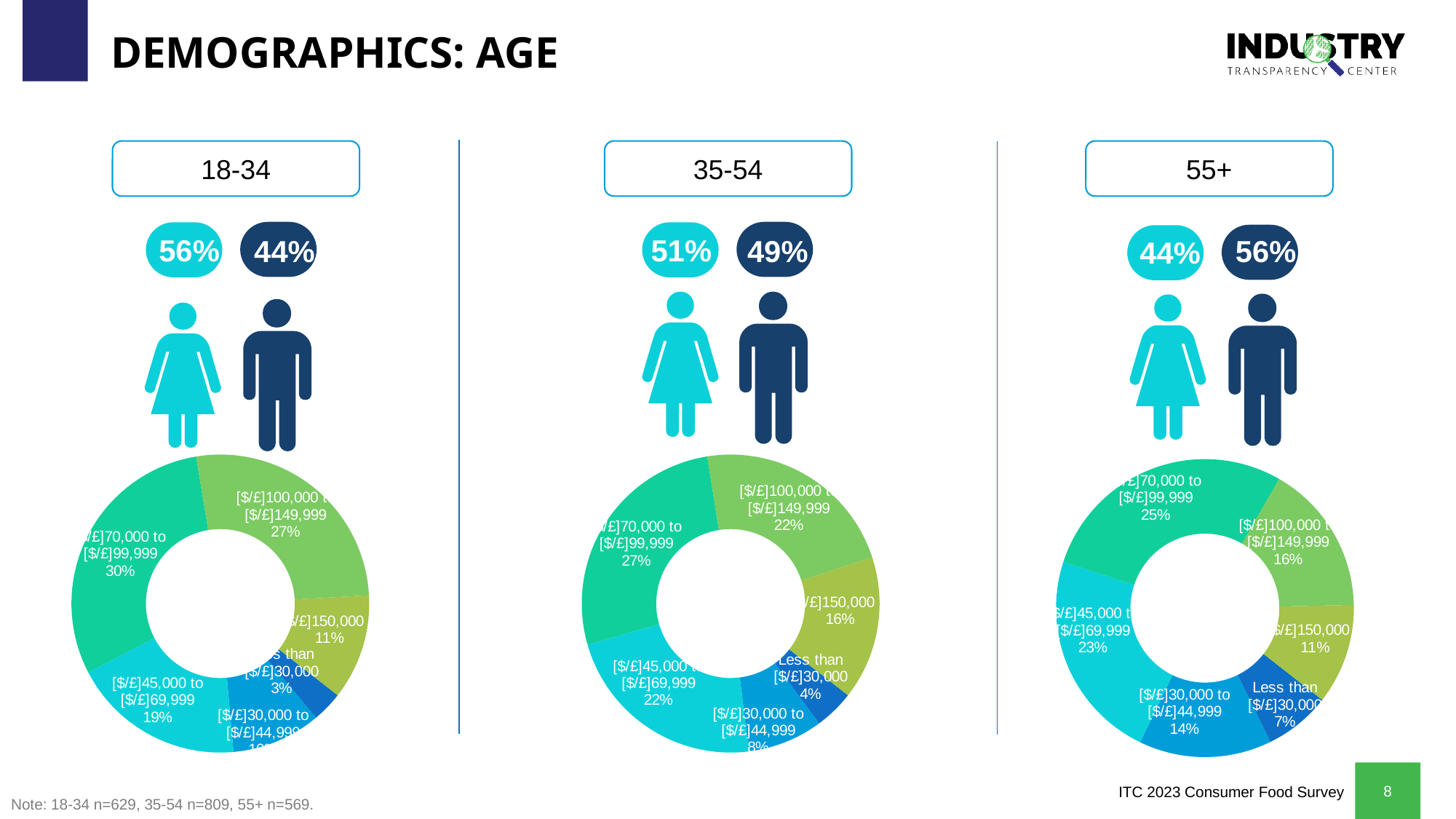
In the 55+ donut chart, what is the difference between the shares for [$/£]30,000 to [$/£]44,999 and Less than [$/£]30,000? 7% In the 35-54 donut chart, which is larger: the share for [$/£]70,000 to [$/£]99,999 or the share for [$/£]150,000? [$/£]70,000 to [$/£]99,999 In the 18-34 donut chart, what share is shown for [$/£]70,000 to [$/£]99,999? 30% In the 35-54 donut chart, which income category has the smallest share? Less than [$/£]30,000 In the 18-34 donut chart, what share is shown for Less than [$/£]30,000? 3% How many donut charts are on the slide? 3 In the 35-54 donut chart, what share is shown for [$/£]30,000 to [$/£]44,999? 8% In the 18-34 donut chart, what is the difference between the shares for [$/£]70,000 to [$/£]99,999 and [$/£]100,000 to [$/£]149,999? 3% In the 55+ donut chart, what share is shown for [$/£]45,000 to [$/£]69,999? 23% In the 55+ donut chart, which income category has the largest share? [$/£]70,000 to [$/£]99,999 How many income categories does the 35-54 donut chart show? 6 What kind of chart is used to show the income distribution for each age group? Donut chart